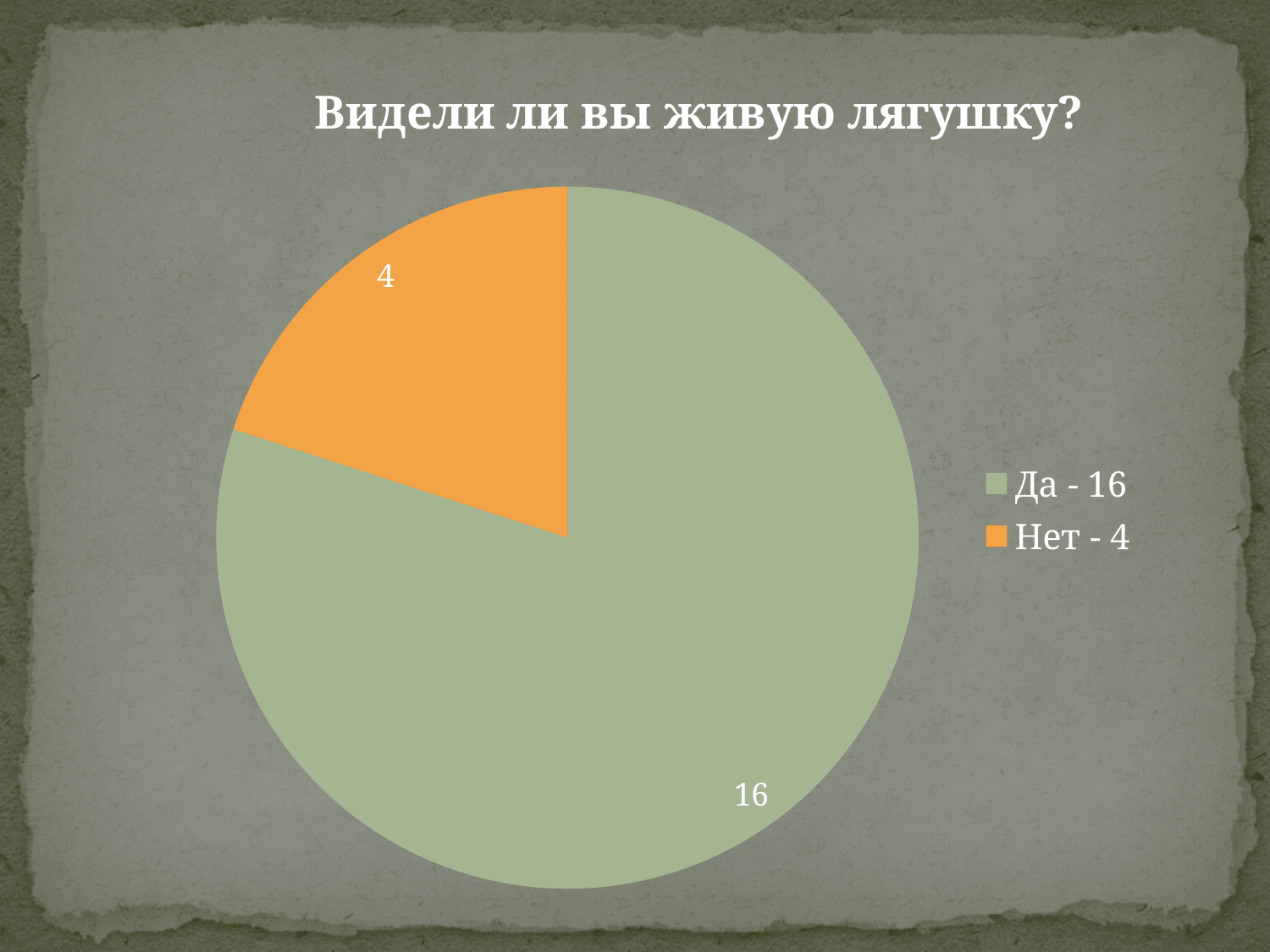
What kind of chart is shown on the slide? pie chart What is the value for "Нет"? 4 Which category has the largest slice? Да How many entries does the legend list? 2 What is the title of the chart? Видели ли вы живую лягушку? What is the value for "Да"? 16 What colour is the "Нет" slice? orange How many slices does the pie chart have? 2 What share of the pie does the "Нет" slice represent? 20% Which is larger, the value for "Да" or the value for "Нет"? Да What is the difference between the values for "Да" and "Нет"? 12 Which category has the smallest slice? Нет